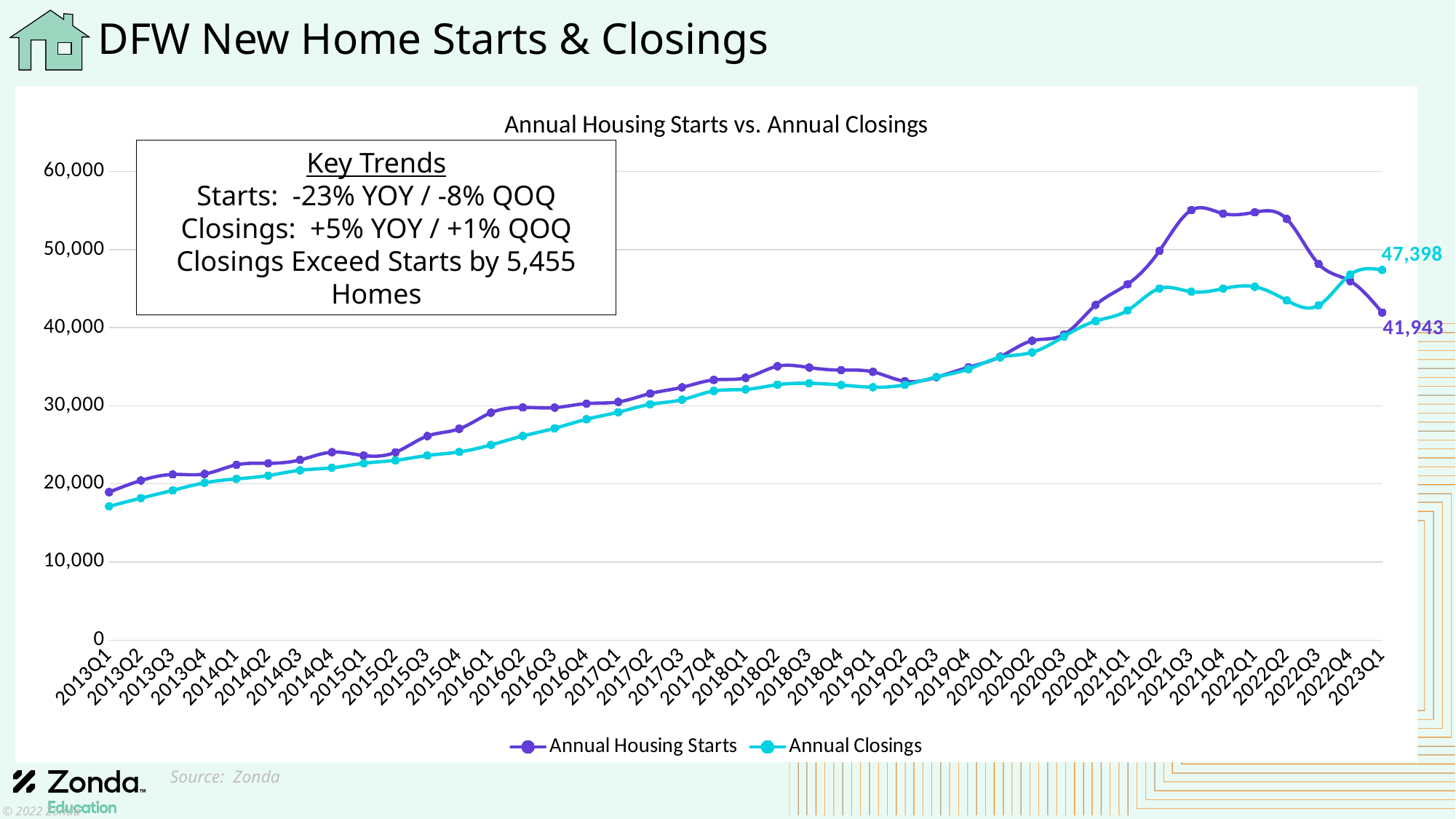
Is the value for Annual Housing Starts at 2021Q3 greater or less than 50,000? greater What is the value of Annual Closings at 2023Q1? 47,398 What type of chart is shown on the slide? Line chart At 2023Q1, which is larger: Annual Housing Starts or Annual Closings? Annual Closings What is the value of Annual Housing Starts at 2023Q1? 41,943 What is the title of the chart? Annual Housing Starts vs. Annual Closings At 2021Q3, which is larger: Annual Housing Starts or Annual Closings? Annual Housing Starts Is the value for Annual Closings at 2013Q1 greater or less than 20,000? less How many series does the chart legend list? 2 How many quarters are plotted along the x axis? 41 By how much do Annual Closings exceed Annual Housing Starts at 2023Q1? 5,455 Which quarter has the lowest value for Annual Housing Starts? 2013Q1